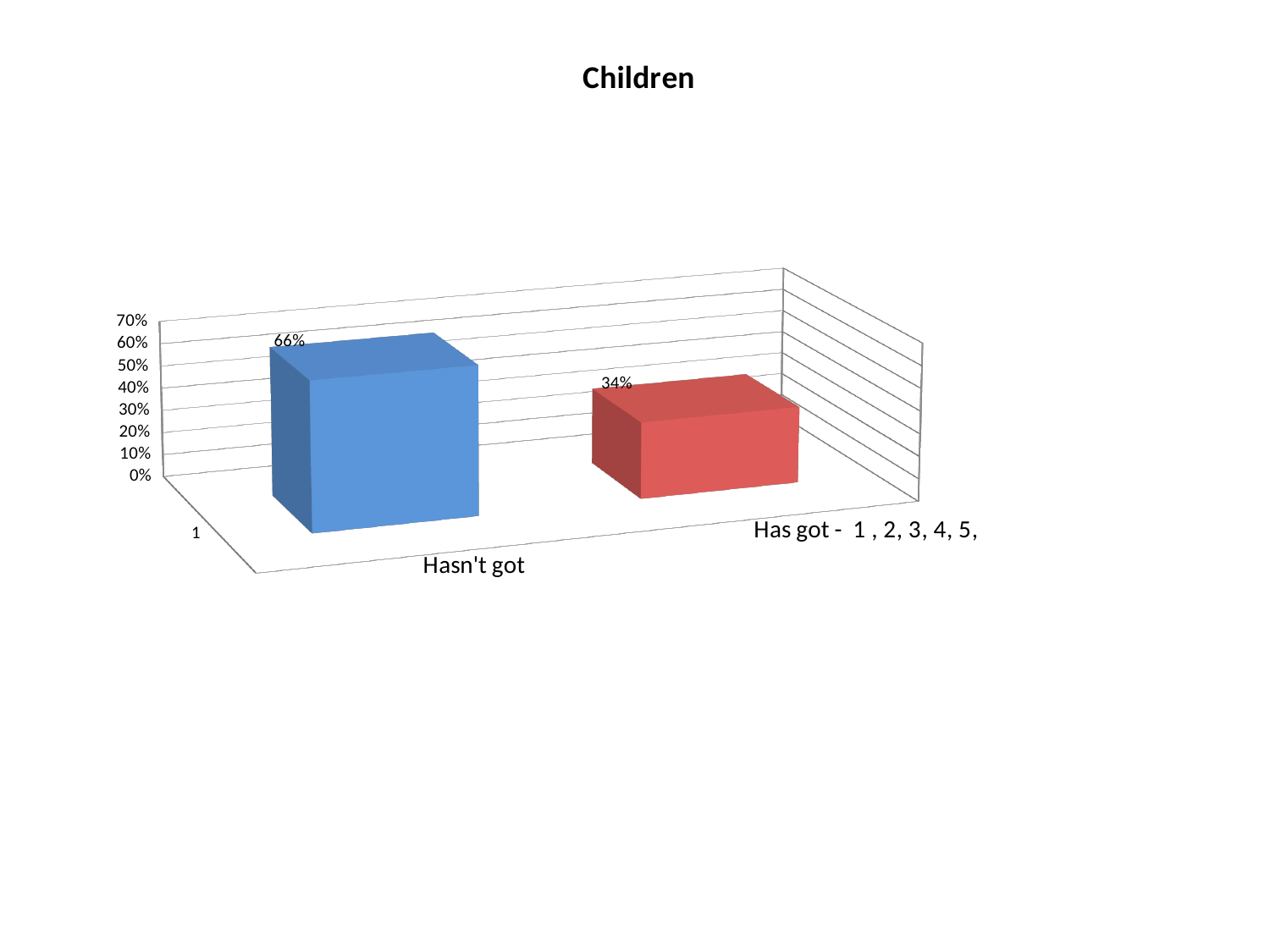
What is the value for "Hasn't got"? 66% How many bars are plotted in the chart? 2 What is the title of the chart? Children Is the value for "Hasn't got" greater or less than 50%? greater What kind of chart is shown on the slide? bar chart What is the value for "Has got - 1, 2, 3, 4, 5,"? 34% What colour is the bar for "Hasn't got"? blue Is the value for "Has got - 1, 2, 3, 4, 5," greater or less than 40%? less Which is larger, the value for "Hasn't got" or the value for "Has got - 1, 2, 3, 4, 5,"? Hasn't got Which category has the highest value? Hasn't got Which category has the lowest value? Has got - 1, 2, 3, 4, 5, What is the difference between the values for "Hasn't got" and "Has got - 1, 2, 3, 4, 5,"? 32%